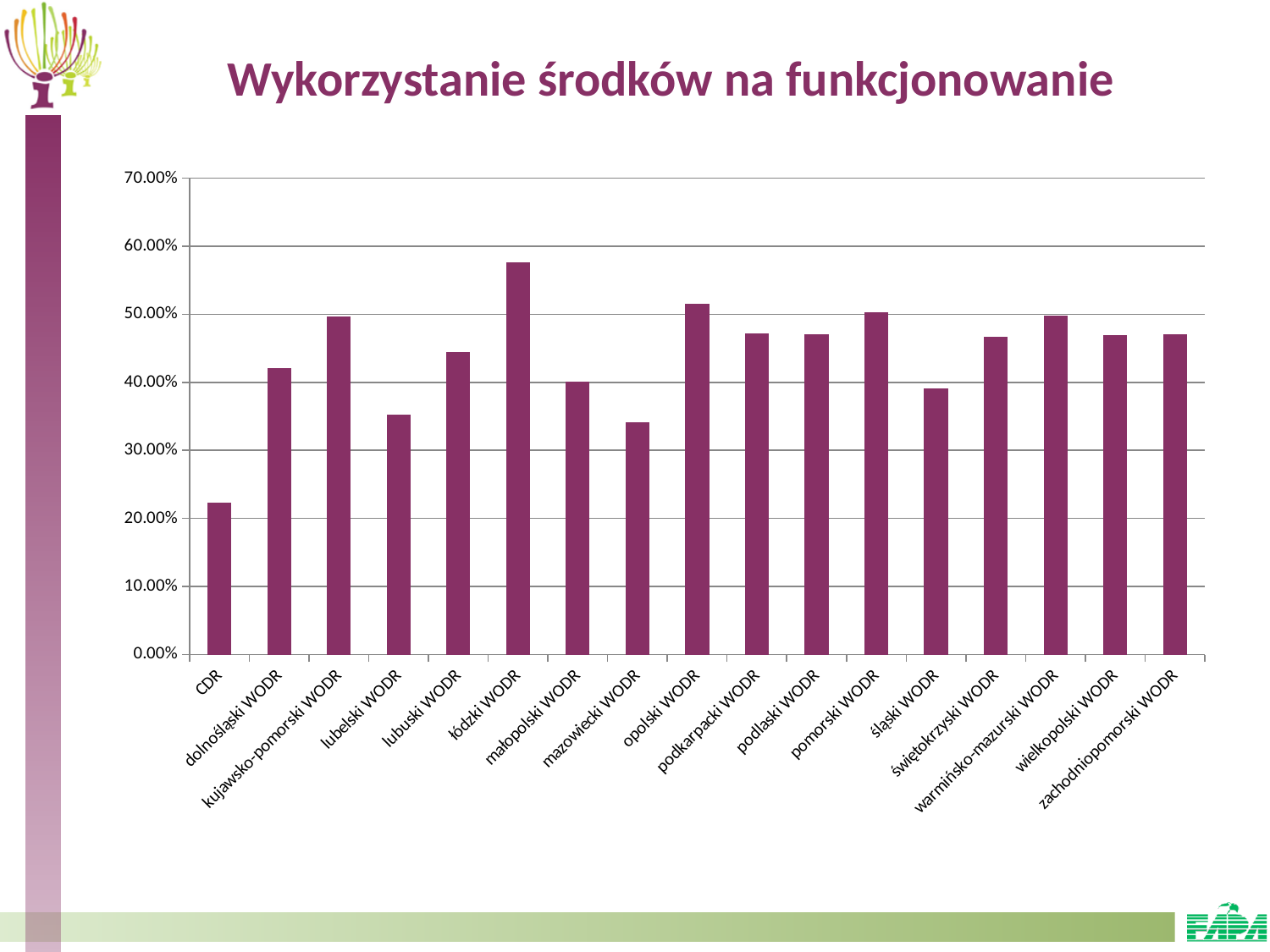
Is the value for łódzki WODR greater or less than 50.00%? greater Is the value for mazowiecki WODR greater or less than 40.00%? less Which is larger, the value for CDR or the value for mazowiecki WODR? mazowiecki WODR Which is larger, the value for łódzki WODR or the value for opolski WODR? łódzki WODR Which category has the lowest value in the chart? CDR Which is larger, the value for lubelski WODR or the value for lubuski WODR? lubuski WODR What kind of chart is shown on the slide? bar chart How many categories are shown on the x axis of the chart? 17 Which category has the highest value in the chart? łódzki WODR What is the title of the chart? Wykorzystanie środków na funkcjonowanie Is the value for lubelski WODR greater or less than 30.00%? greater